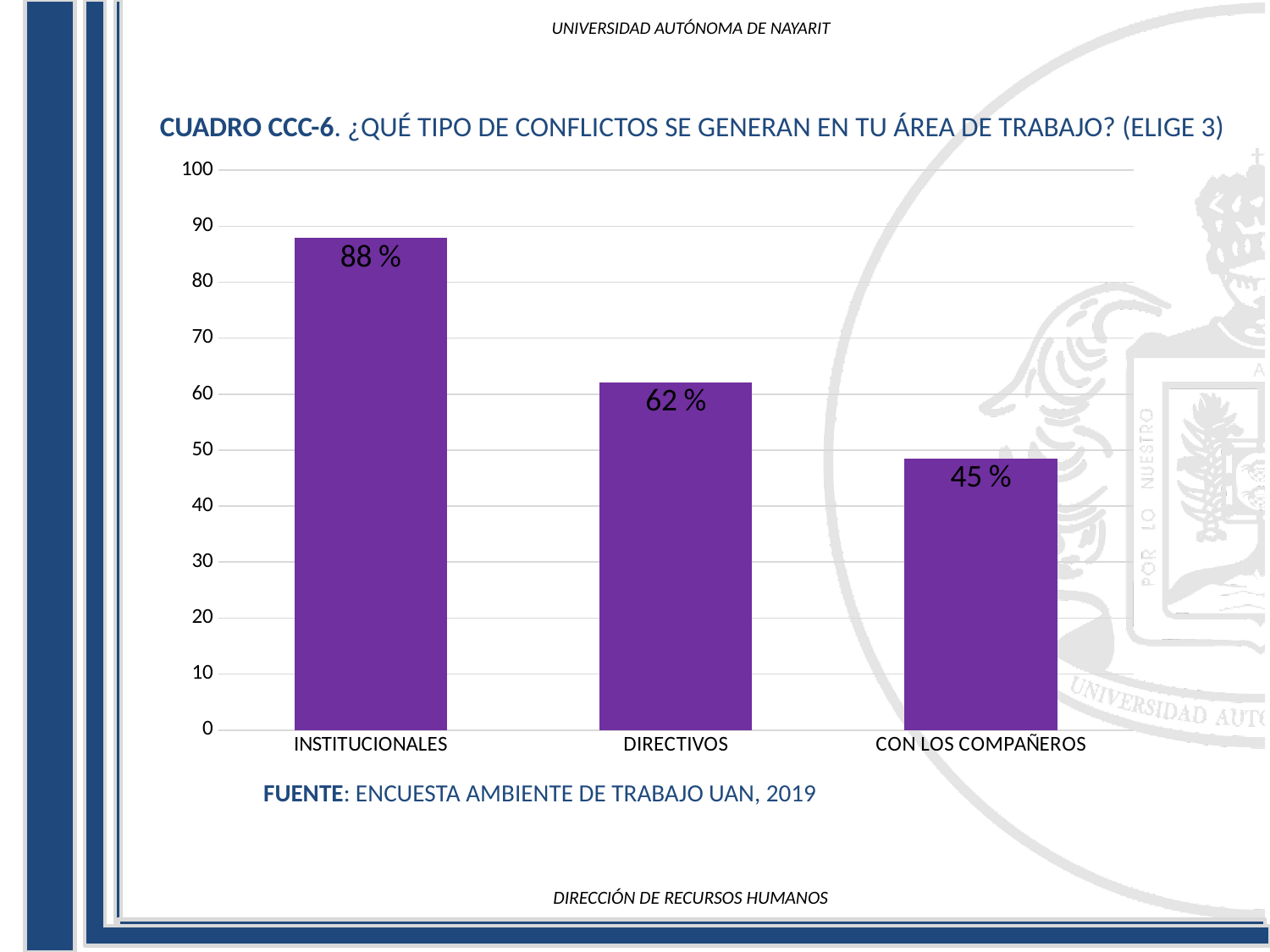
Which category has the lowest value? CON LOS COMPAÑEROS What source is cited below the chart? ENCUESTA AMBIENTE DE TRABAJO UAN, 2019 Which category has the highest value? INSTITUCIONALES What is the difference between the values for DIRECTIVOS and CON LOS COMPAÑEROS? 17 % What is the value for DIRECTIVOS? 62 % How many categories are shown on the chart? 3 What is the difference between the values for INSTITUCIONALES and DIRECTIVOS? 26 % What is the value for CON LOS COMPAÑEROS? 45 % What is the value for INSTITUCIONALES? 88 % Which is larger, the value for DIRECTIVOS or the value for CON LOS COMPAÑEROS? DIRECTIVOS What kind of chart is shown on the slide? bar chart Is the value for CON LOS COMPAÑEROS greater or less than 50? less